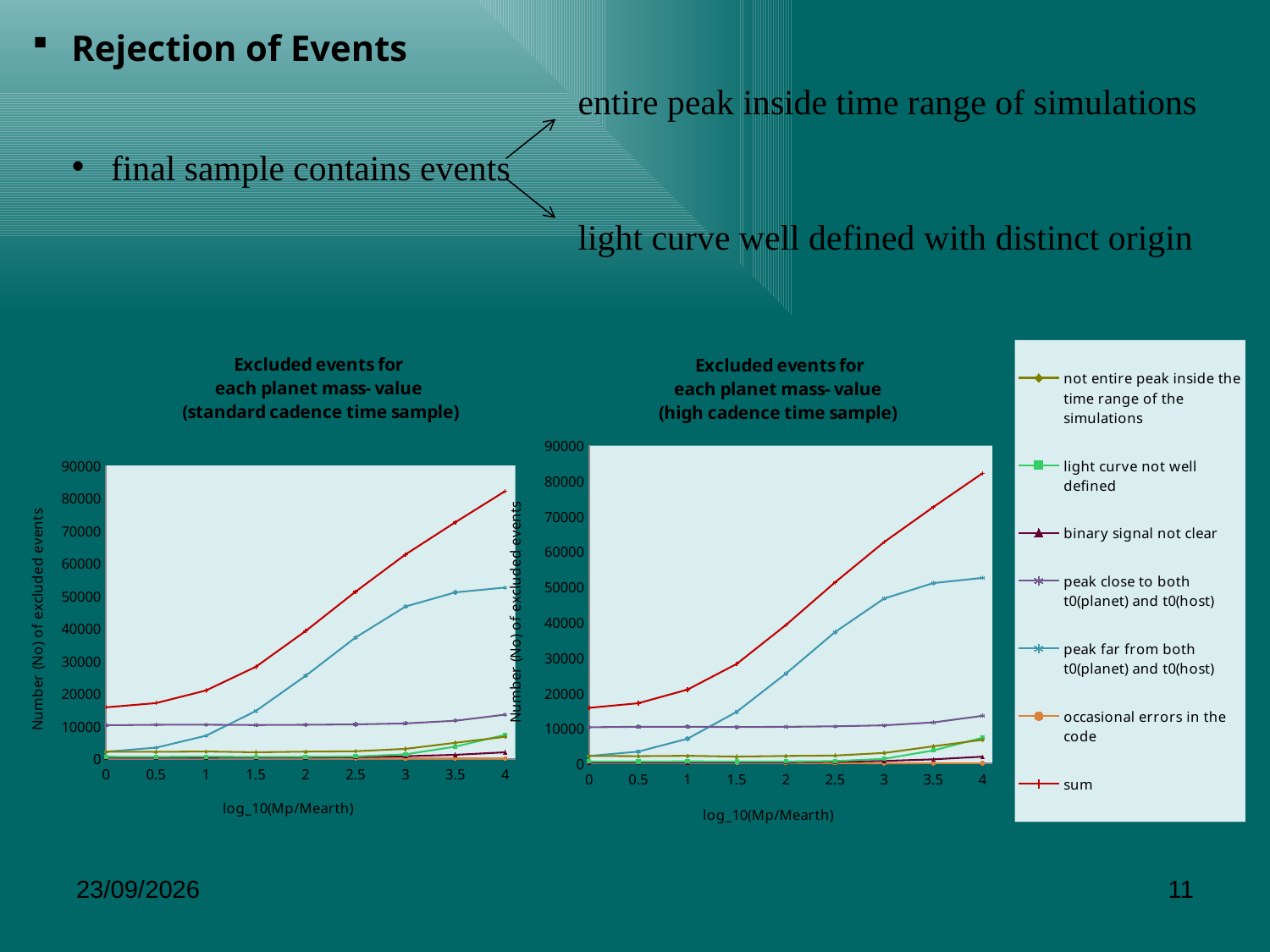
What is the x-axis label of the right chart (high cadence time sample)? log_10(Mp/Mearth) In the left chart (standard cadence time sample), does the 'sum' series rise or fall as log_10(Mp/Mearth) increases from 0 to 4? rises What is the y-axis label of the left chart (standard cadence time sample)? Number (No) of excluded events In the right chart (high cadence time sample), is the value of 'peak far from both t0(planet) and t0(host)' at log_10(Mp/Mearth) = 4 greater or less than 40000? greater In the left chart (standard cadence time sample), at log_10(Mp/Mearth) = 0, which is larger: 'peak close to both t0(planet) and t0(host)' or 'peak far from both t0(planet) and t0(host)'? peak close to both t0(planet) and t0(host) What kind of chart is the left chart, 'Excluded events for each planet mass-value (standard cadence time sample)'? line chart In the left chart (standard cadence time sample), which series stays lowest across the whole x axis? occasional errors in the code How many series does the legend on the right of the slide list? 7 In the left chart (standard cadence time sample), is the value of 'sum' at log_10(Mp/Mearth) = 4 greater or less than 70000? greater In the right chart (high cadence time sample), is the value of 'sum' at log_10(Mp/Mearth) = 0 greater or less than 10000? greater In the right chart (high cadence time sample), how many x-axis points are plotted for each series, from 0 to 4? 9 In the right chart (high cadence time sample), which series reaches the highest value at log_10(Mp/Mearth) = 4? sum